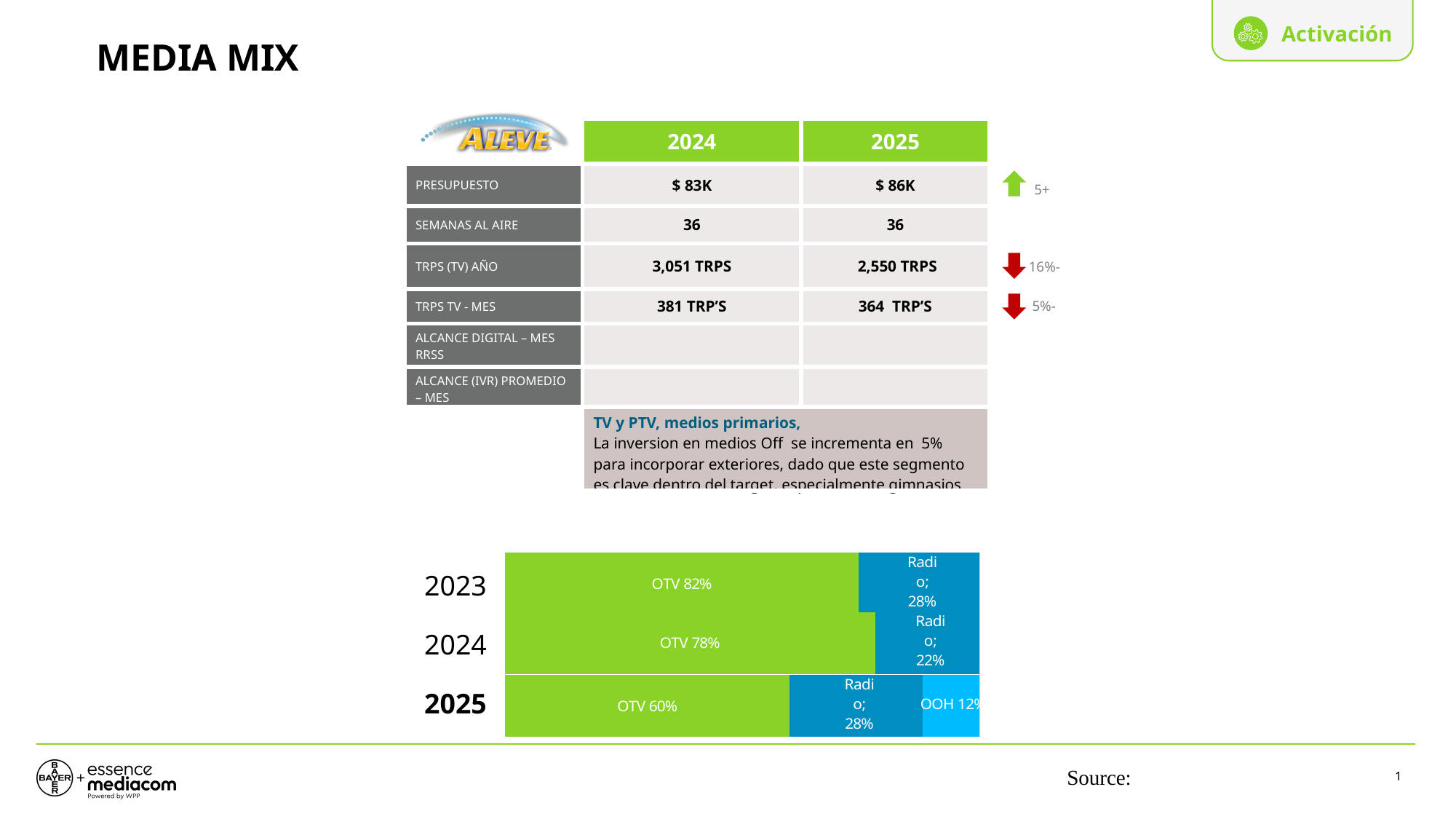
In the stacked bar chart, what is the OTV share for 2023? 82% In the stacked bar chart, which year is the only one that includes an OOH segment? 2025 How many years (bars) are shown in the stacked bar chart? 3 In the stacked bar chart, what is the OTV share for 2025? 60% In the stacked bar chart, by how many percentage points does the OTV share drop from 2024 to 2025? 18 percentage points In the stacked bar chart, which year has the highest OTV share? 2023 In the stacked bar chart, is the Radio share larger in 2024 or in 2025? 2025 In the stacked bar chart, what is the OOH share for 2025? 12% In the stacked bar chart, which year has the lowest OTV share? 2025 What kind of chart is shown at the bottom of the slide? Stacked bar chart In the stacked bar chart, does the OTV share rise or fall from 2023 to 2025? Fall In the stacked bar chart, what is the Radio share for 2024? 22%